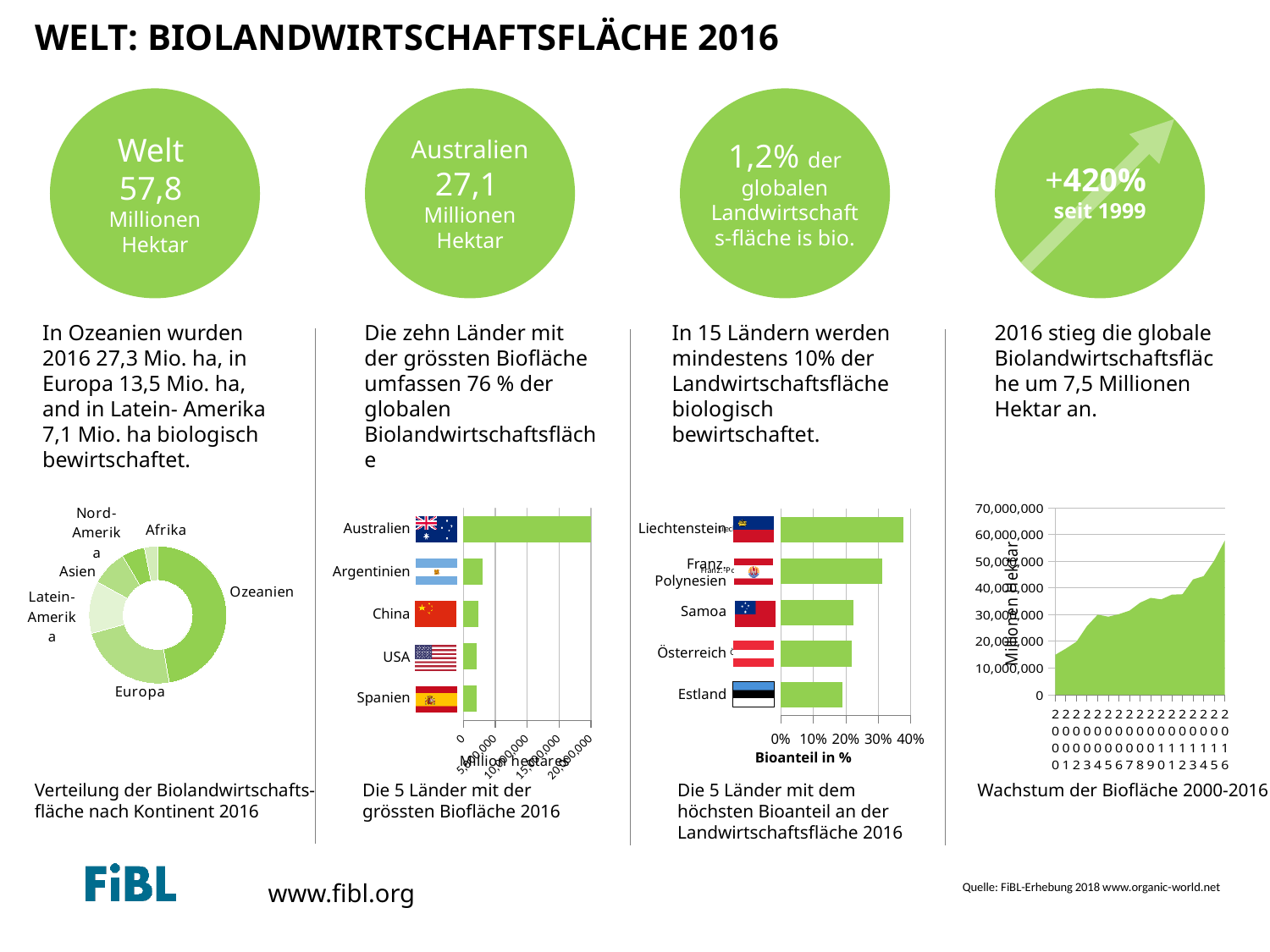
In the chart 'Verteilung der Biolandwirtschaftsfläche nach Kontinent 2016', which continent has the largest slice? Ozeanien In the chart 'Die 5 Länder mit dem höchsten Bioanteil an der Landwirtschaftsfläche 2016', which is larger, the value for Liechtenstein or the value for Samoa? Liechtenstein In the chart 'Wachstum der Biofläche 2000-2016', do the values generally rise or fall from 2000 to 2016? rise In the chart 'Verteilung der Biolandwirtschaftsfläche nach Kontinent 2016', how many continents are shown? 6 In the chart 'Die 5 Länder mit der grössten Biofläche 2016', is the value for Argentinien greater or less than 5,000,000? less What kind of chart is the chart titled 'Verteilung der Biolandwirtschaftsfläche nach Kontinent 2016'? doughnut chart In the chart 'Die 5 Länder mit der grössten Biofläche 2016', is the value for Australien greater or less than 20,000,000? greater What is the x-axis title of the chart 'Die 5 Länder mit dem höchsten Bioanteil an der Landwirtschaftsfläche 2016'? Bioanteil in % In the chart 'Die 5 Länder mit dem höchsten Bioanteil an der Landwirtschaftsfläche 2016', is the value for Liechtenstein greater or less than 30%? greater In the chart 'Die 5 Länder mit dem höchsten Bioanteil an der Landwirtschaftsfläche 2016', which country has the highest share? Liechtenstein In the chart 'Die 5 Länder mit dem höchsten Bioanteil an der Landwirtschaftsfläche 2016', which country has the lowest share? Estland In the chart 'Die 5 Länder mit der grössten Biofläche 2016', which country has the highest value? Australien